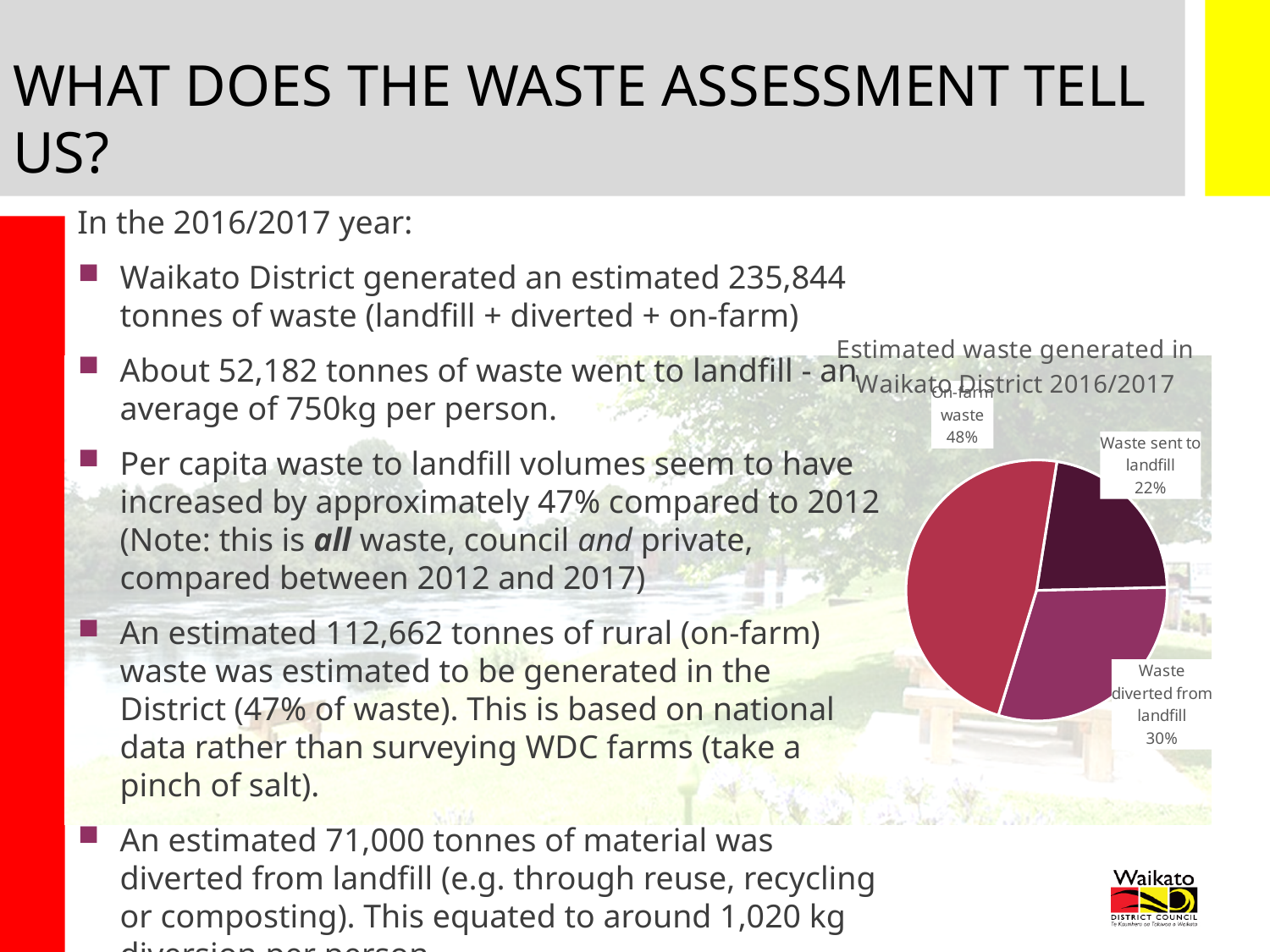
Which category has the smallest slice of the pie? Waste sent to landfill Which category has the largest slice of the pie? On-farm waste How many slices does the pie chart have? 3 What is the difference in percentage points between On-farm waste and Waste sent to landfill? 26 What share of the pie is Waste sent to landfill? 22% What kind of chart is shown on the slide? pie chart What share of the pie is On-farm waste? 48% What share of the pie is Waste diverted from landfill? 30% What is the title of the chart? Estimated waste generated in Waikato District 2016/2017 What is the combined share of Waste sent to landfill and Waste diverted from landfill? 52% Which is larger: Waste diverted from landfill or Waste sent to landfill? Waste diverted from landfill What is the difference in percentage points between On-farm waste and Waste diverted from landfill? 18